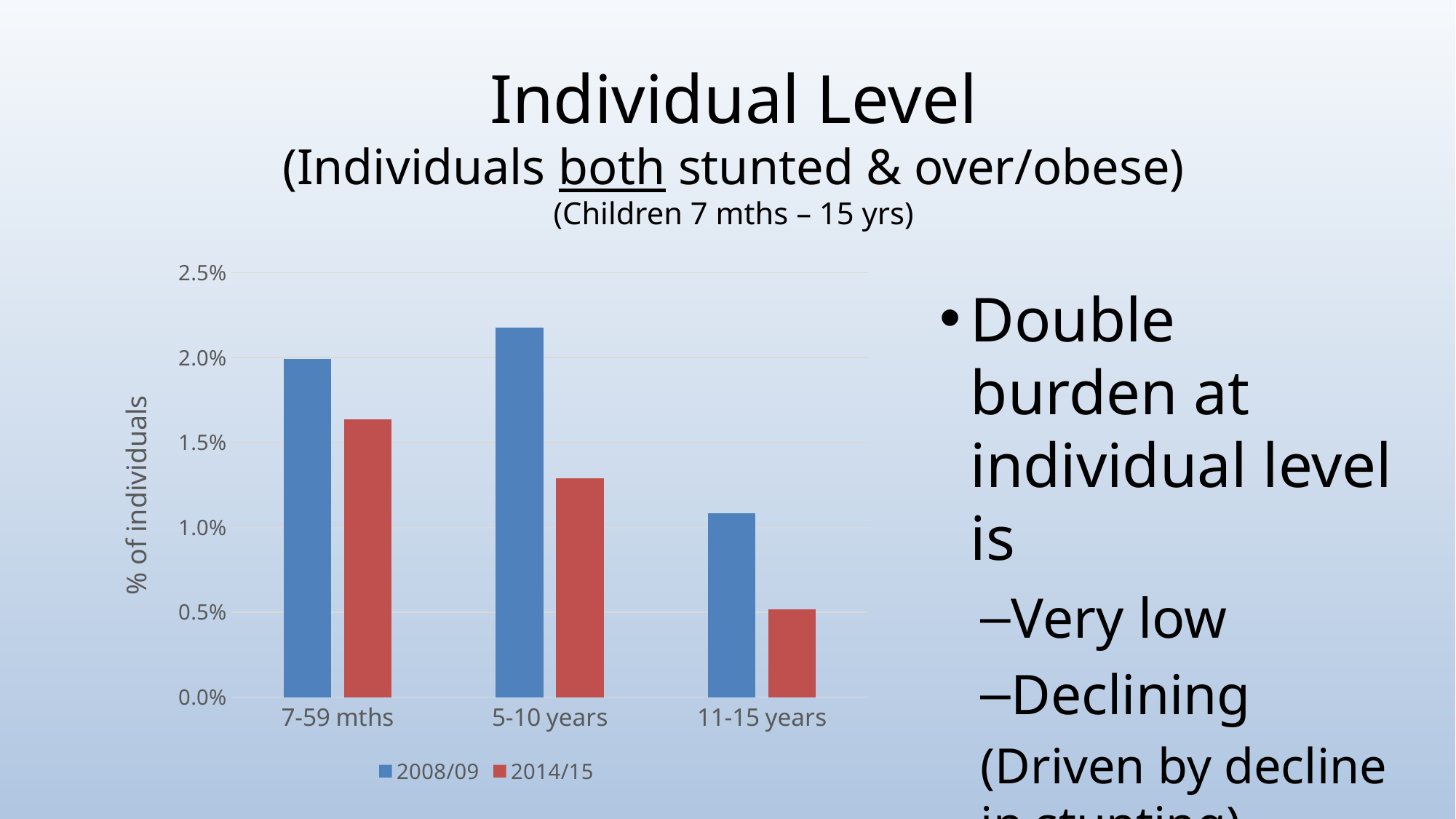
Which age group has the lowest value for 2014/15? 11-15 years Which age group has the highest value for 2008/09? 5-10 years Is the 2008/09 value for 5-10 years greater or less than 2.0%? greater What is the label on the vertical axis of the chart? % of individuals Do the 2014/15 values rise or fall from the 5-10 years group to the 11-15 years group? fall Is the 2014/15 value for 5-10 years greater or less than 1.5%? less What kind of chart is shown on the slide? bar chart Is the 2014/15 value for 11-15 years greater or less than 1.0%? less For the 7-59 mths group, which series has the larger value, 2008/09 or 2014/15? 2008/09 How many series does the chart legend list? 2 How many age groups are shown on the x axis of the chart? 3